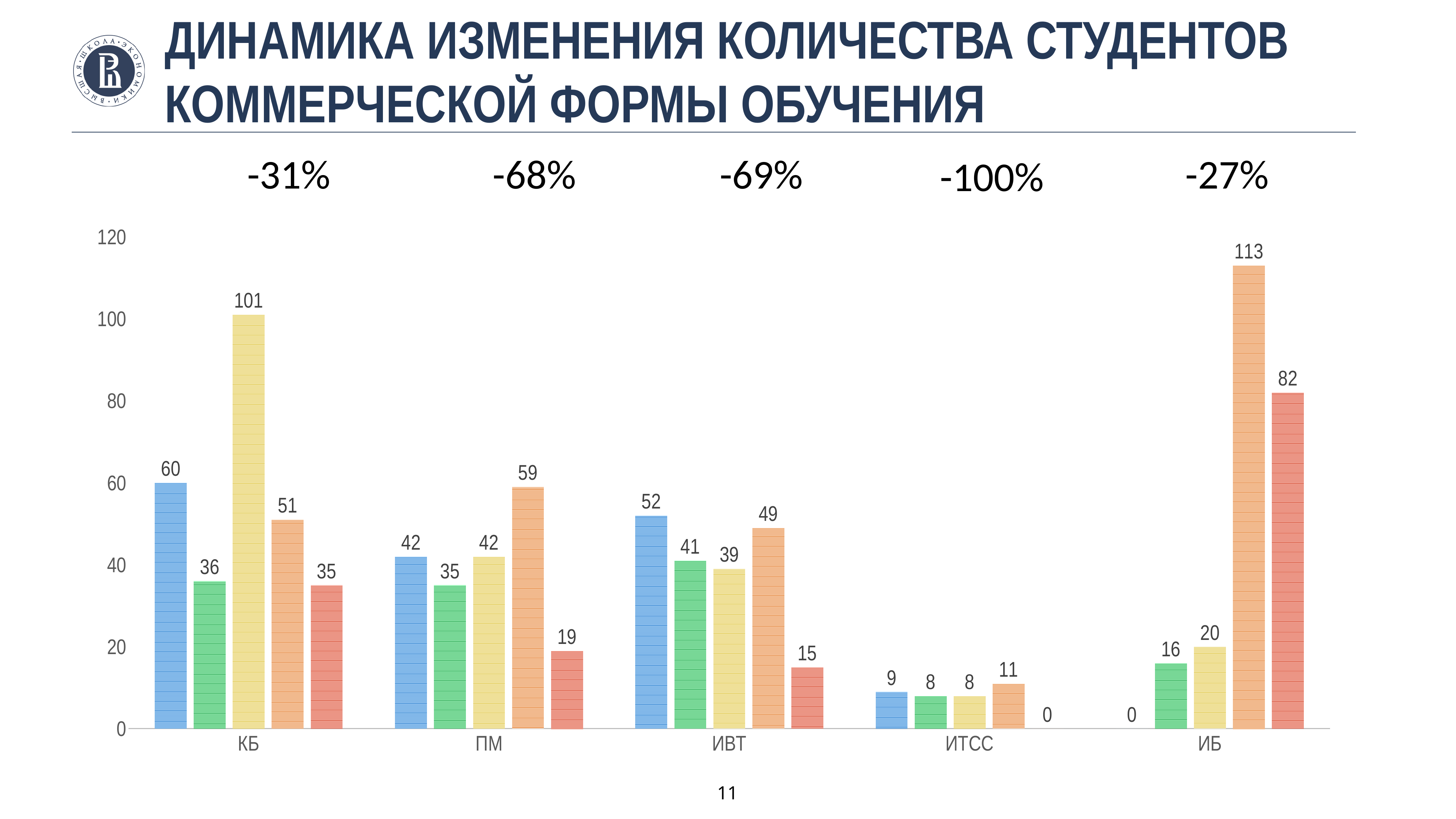
Which category has the tallest bar in the chart? ИБ How many categories are shown on the x axis of the chart? 5 What is the value of the orange bar for ИБ? 113 What type of chart is shown on the slide? bar chart What percentage change is printed above the ИТСС category? -100% What is the value of the red bar for ИТСС? 0 What is the value of the blue bar for КБ? 60 What is the difference between the orange bar and the red bar for ИБ? 31 What percentage change is printed above the КБ category? -31% What is the value of the yellow bar for КБ? 101 What is the value of the red bar for ПМ? 19 Which is larger for ИВТ: the blue bar or the green bar? the blue bar